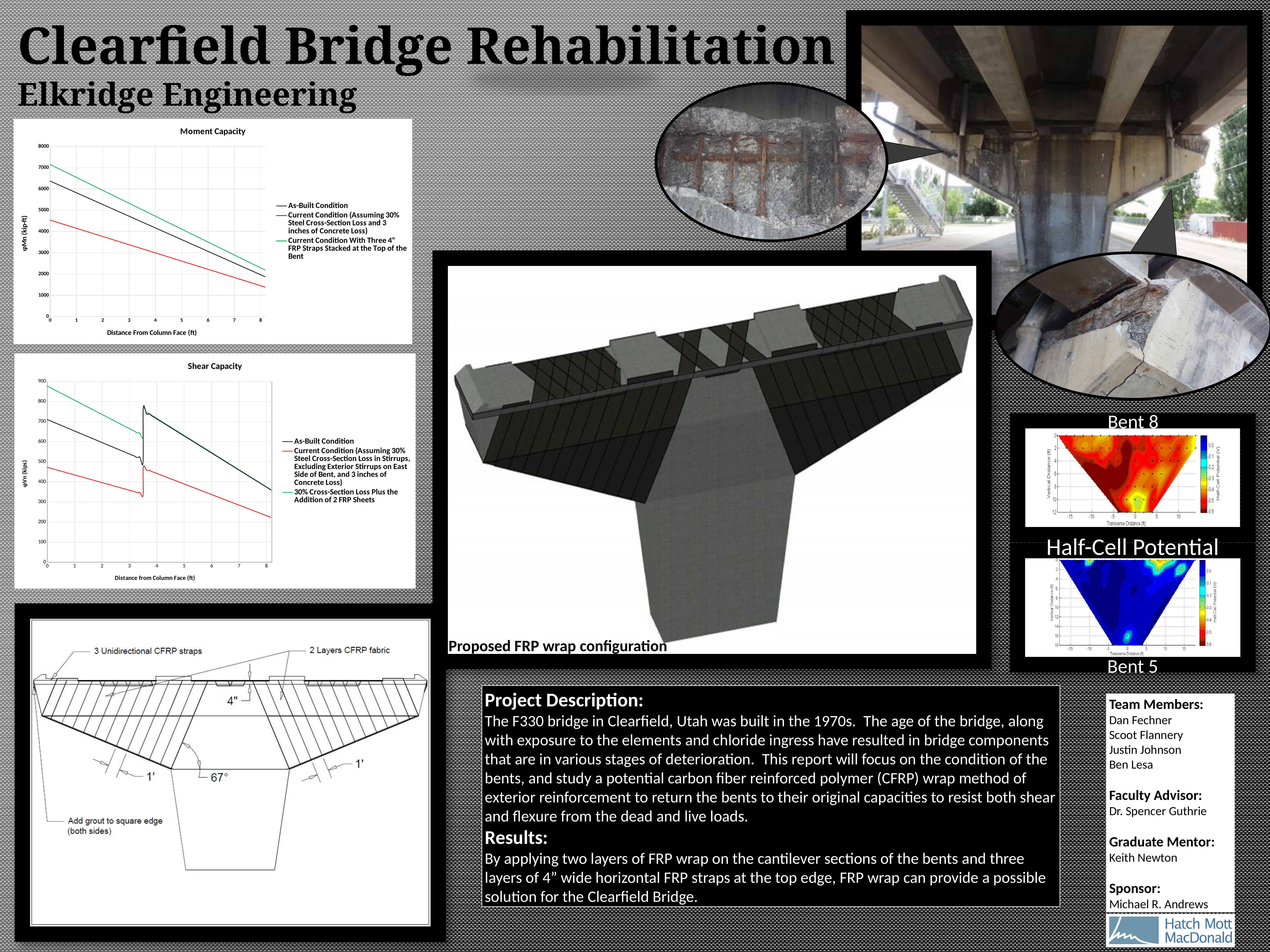
What kind of chart is the Moment Capacity chart? line chart In the Shear Capacity chart, at 0 ft, which is larger: the As-Built Condition value or the Current Condition value? As-Built Condition In the Shear Capacity chart, is the value for 30% Cross-Section Loss Plus the Addition of 2 FRP Sheets at 0 ft greater or less than 800? greater What kind of chart is the Shear Capacity chart? line chart In the Moment Capacity chart, is the As-Built Condition value at 0 ft greater or less than 6000? greater In the Moment Capacity chart, which series has the highest values? Current Condition With Three 4" FRP Straps Stacked at the Top of the Bent What is the y-axis label of the Shear Capacity chart? φVn (kips) In the Moment Capacity chart, which series has the lowest values? Current Condition (Assuming 30% Steel Cross-Section Loss and 3 inches of Concrete Loss) In the Moment Capacity chart, is the Current Condition (Assuming 30% Steel Cross-Section Loss and 3 inches of Concrete Loss) value at 0 ft greater or less than 5000? less How many series does the legend of the Moment Capacity chart list? 3 How many series does the legend of the Shear Capacity chart list? 3 In the Moment Capacity chart, do the values rise or fall as the distance from the column face increases? fall